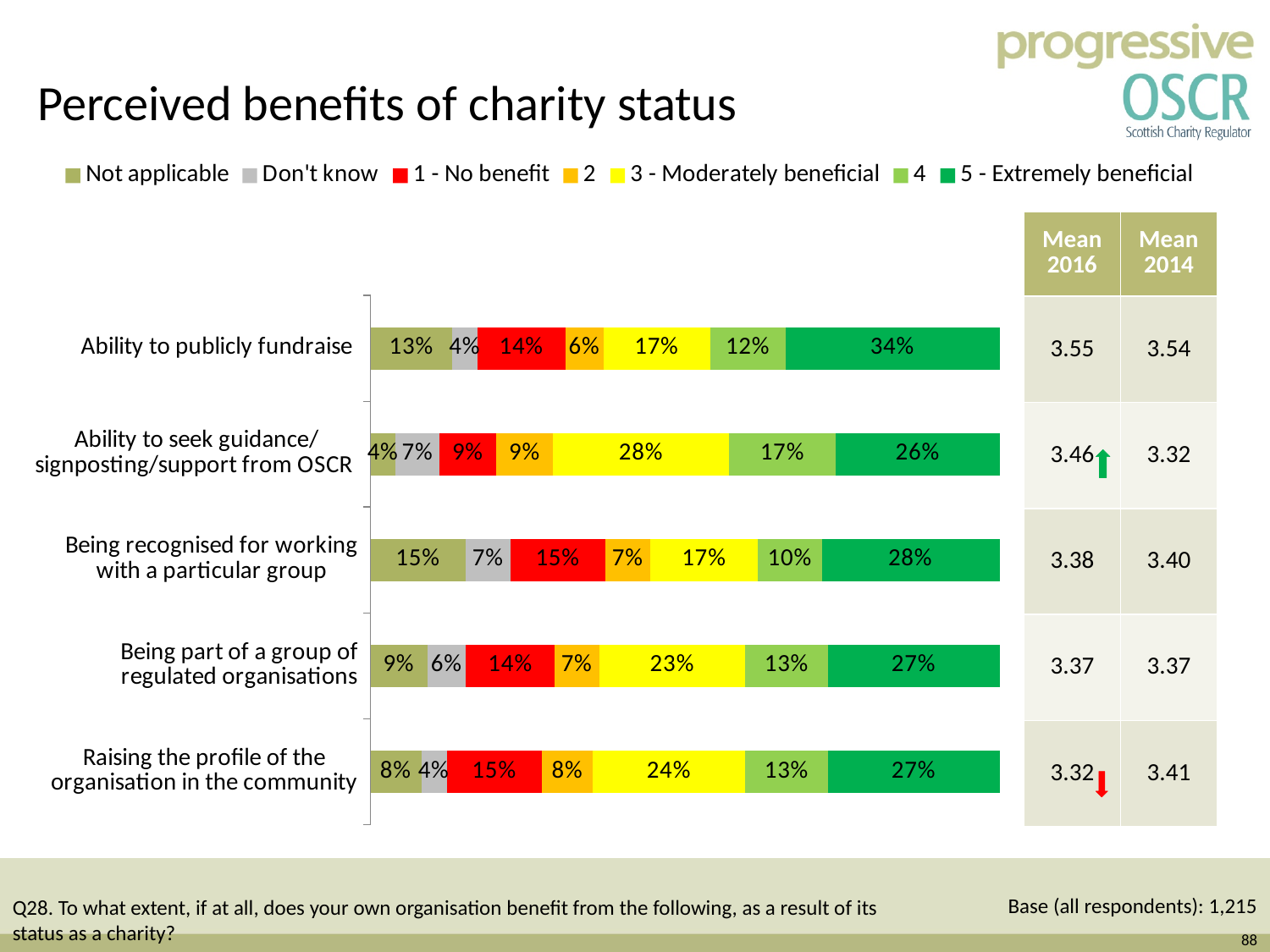
Which is larger: the 3 - Moderately beneficial share for 'Being part of a group of regulated organisations' or for 'Being recognised for working with a particular group'? Being part of a group of regulated organisations Which colour represents '1 - No benefit' in the chart? Red What percentage of respondents answered 'Not applicable' for 'Being recognised for working with a particular group'? 15% What percentage of respondents rated 'Ability to publicly fundraise' as 5 - Extremely beneficial? 34% What is the difference between the 5 - Extremely beneficial share for 'Ability to publicly fundraise' and for 'Ability to seek guidance/signposting/support from OSCR'? 8% What percentage of respondents rated 'Raising the profile of the organisation in the community' as 1 - No benefit? 15% How many series does the legend list? 7 What percentage of respondents rated 'Ability to seek guidance/signposting/support from OSCR' as 3 - Moderately beneficial? 28% How many benefits (categories) are shown in the chart? 5 Which benefit has the highest share of respondents rating it 5 - Extremely beneficial? Ability to publicly fundraise What type of chart is shown on the slide? Stacked bar chart Which benefit has the lowest share of respondents rating it 1 - No benefit? Ability to seek guidance/signposting/support from OSCR